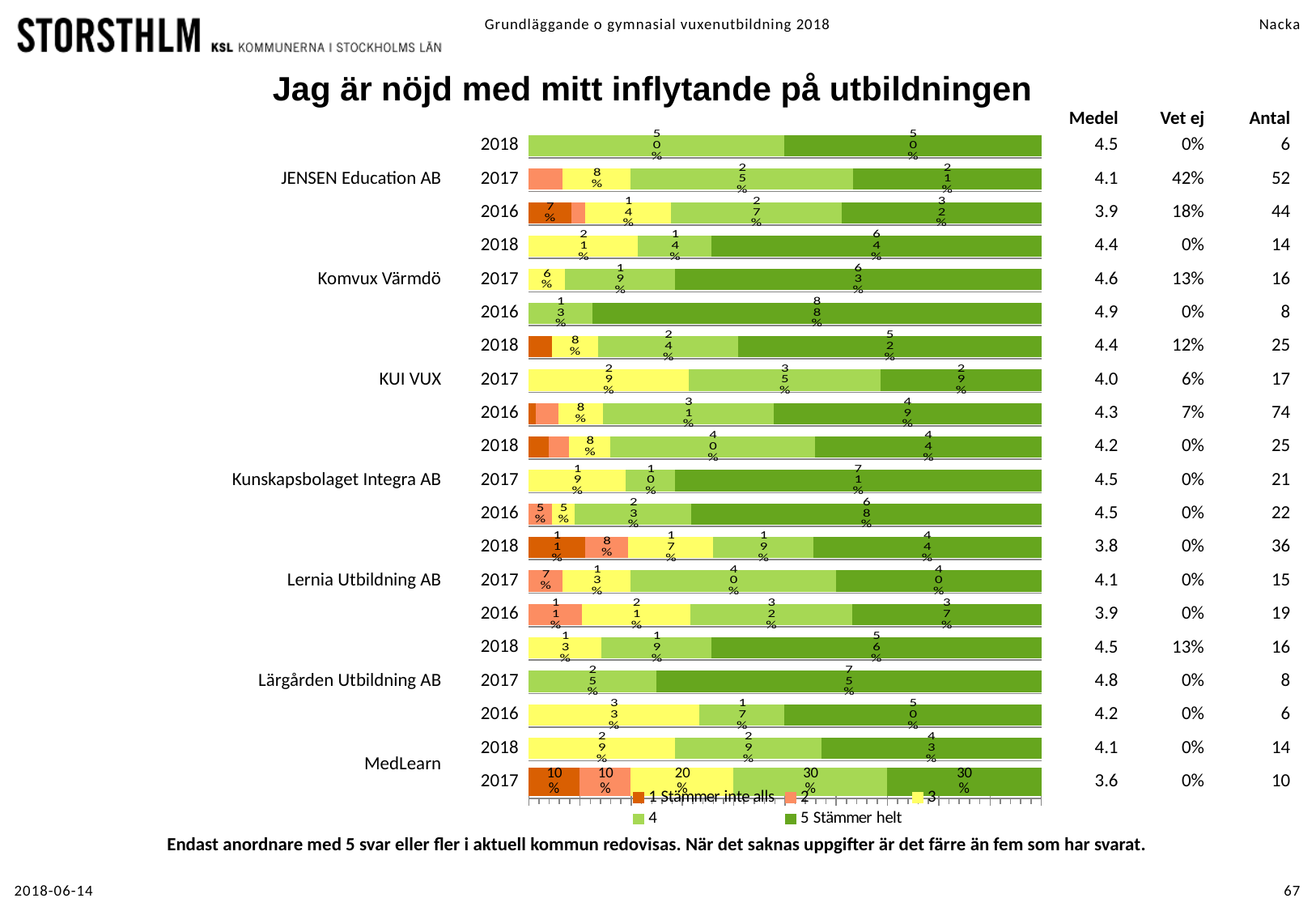
How many education providers are shown in the chart? 7 What is the title of the chart? Jag är nöjd med mitt inflytande på utbildningen What percentage of MedLearn respondents in 2017 answered "1 Stämmer inte alls"? 10% How many series does the legend list? 5 Which has a larger share of "5 Stämmer helt": Komvux Värmdö in 2018 or Lernia Utbildning AB in 2017? Komvux Värmdö in 2018 For Lärgården Utbildning AB in 2016, what is the difference between the share answering "5 Stämmer helt" and the share answering "3"? 17 percentage points What percentage of JENSEN Education AB respondents in 2018 answered "5 Stämmer helt"? 50% What percentage of Lernia Utbildning AB respondents in 2018 answered "5 Stämmer helt"? 44% What percentage of Kunskapsbolaget Integra AB respondents in 2017 answered "5 Stämmer helt"? 71% What percentage of Komvux Värmdö respondents in 2016 answered "5 Stämmer helt"? 88% What kind of chart is shown on the slide? Stacked bar chart What percentage of Lärgården Utbildning AB respondents in 2017 answered "4"? 25%